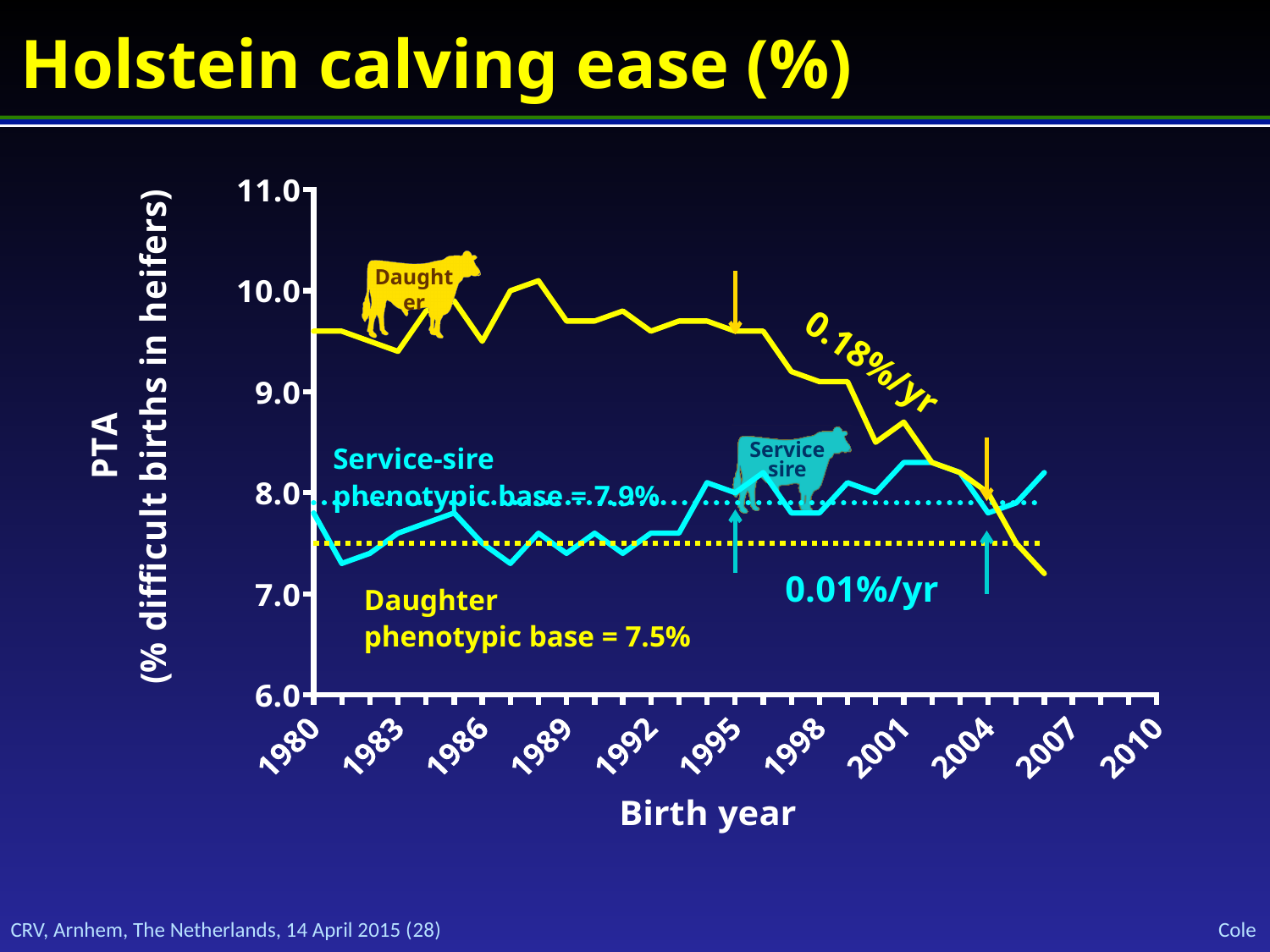
How many series are plotted in the chart? 4 What annual rate of change is annotated next to the Daughter line? 0.18%/yr In birth year 1980, which series has the higher value, Daughter or Service sire? Daughter What is the Daughter phenotypic base shown on the chart? 7.5% What kind of chart is shown on the slide? line chart What is the label of the x axis? Birth year Does the Daughter line rise or fall overall from 1980 to 2006? fall Is the Daughter value for birth year 1980 greater or less than 9.0? greater Is the Daughter value for birth year 2006 greater or less than 8.0? less What annual rate of change is annotated for the Service sire line? 0.01%/yr What is the title of the chart on the slide? Holstein calving ease (%) What is the Service-sire phenotypic base shown on the chart? 7.9%